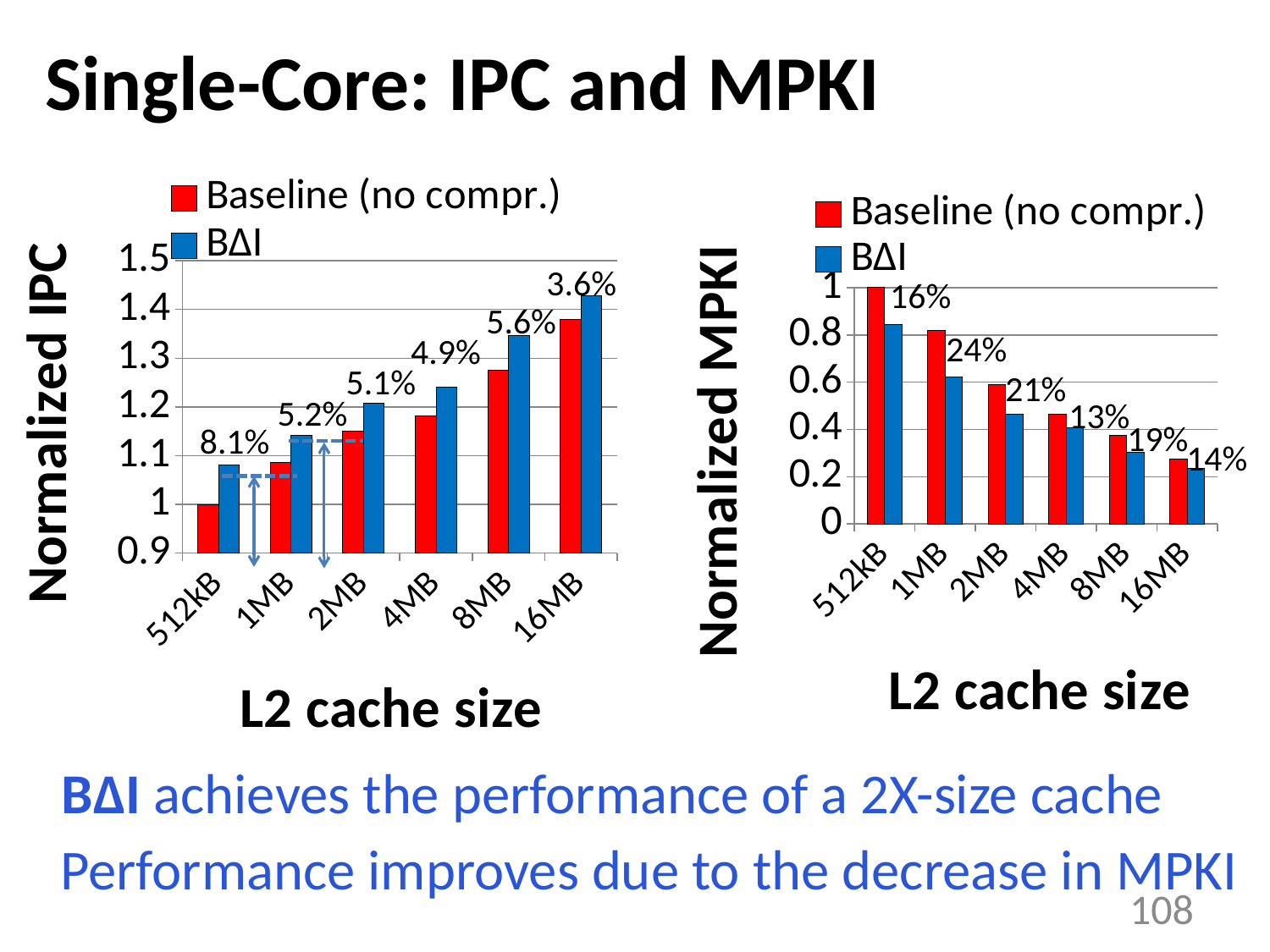
In the Normalized MPKI chart, what is the Baseline (no compr.) value at 512kB? 1 In the Normalized IPC chart, what percentage label is shown above the 512kB bars? 8.1% In the Normalized IPC chart, is the BΔI value at 8MB greater or less than 1.3? greater In the Normalized MPKI chart, which cache size has the largest percentage label? 1MB How many L2 cache sizes are shown on the x axis of the Normalized IPC chart? 6 How many series does the legend of the Normalized MPKI chart list? 2 In the Normalized MPKI chart, which is larger at 1MB: Baseline (no compr.) or BΔI? Baseline (no compr.) In the Normalized MPKI chart, what percentage label is shown next to the 1MB bars? 24% In the Normalized IPC chart, do the bar values rise or fall as the L2 cache size increases? rise In the Normalized IPC chart, which cache size has the smallest percentage label? 16MB What kind of chart is the Normalized IPC chart on the left? bar chart In the Normalized MPKI chart, is the BΔI value at 512kB greater or less than 0.8? greater